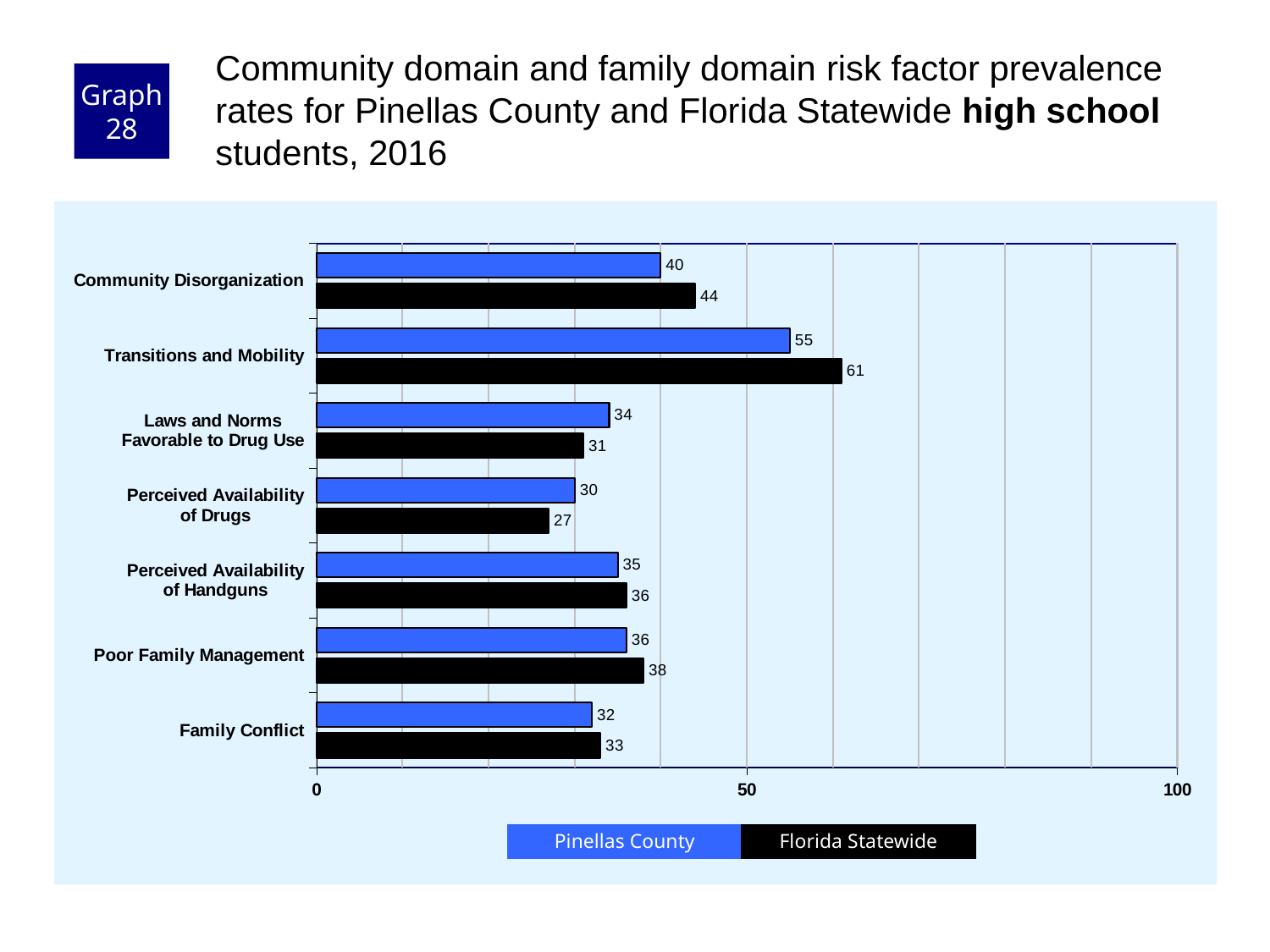
Is the Florida Statewide value for Transitions and Mobility greater or less than 50? greater Which risk factor has the lowest Pinellas County value? Perceived Availability of Drugs Which colour represents Florida Statewide in the chart? black What is the difference between the Florida Statewide and Pinellas County values for Transitions and Mobility? 6 What kind of chart is shown on the slide? bar chart Which risk factor has the highest Florida Statewide value? Transitions and Mobility What is the Florida Statewide value for Perceived Availability of Drugs? 27 For Laws and Norms Favorable to Drug Use, which is larger: the Pinellas County value or the Florida Statewide value? Pinellas County How many risk factor categories are shown on the chart? 7 What is the Pinellas County value for Transitions and Mobility? 55 How many series does the legend list? 2 What is the Florida Statewide value for Community Disorganization? 44